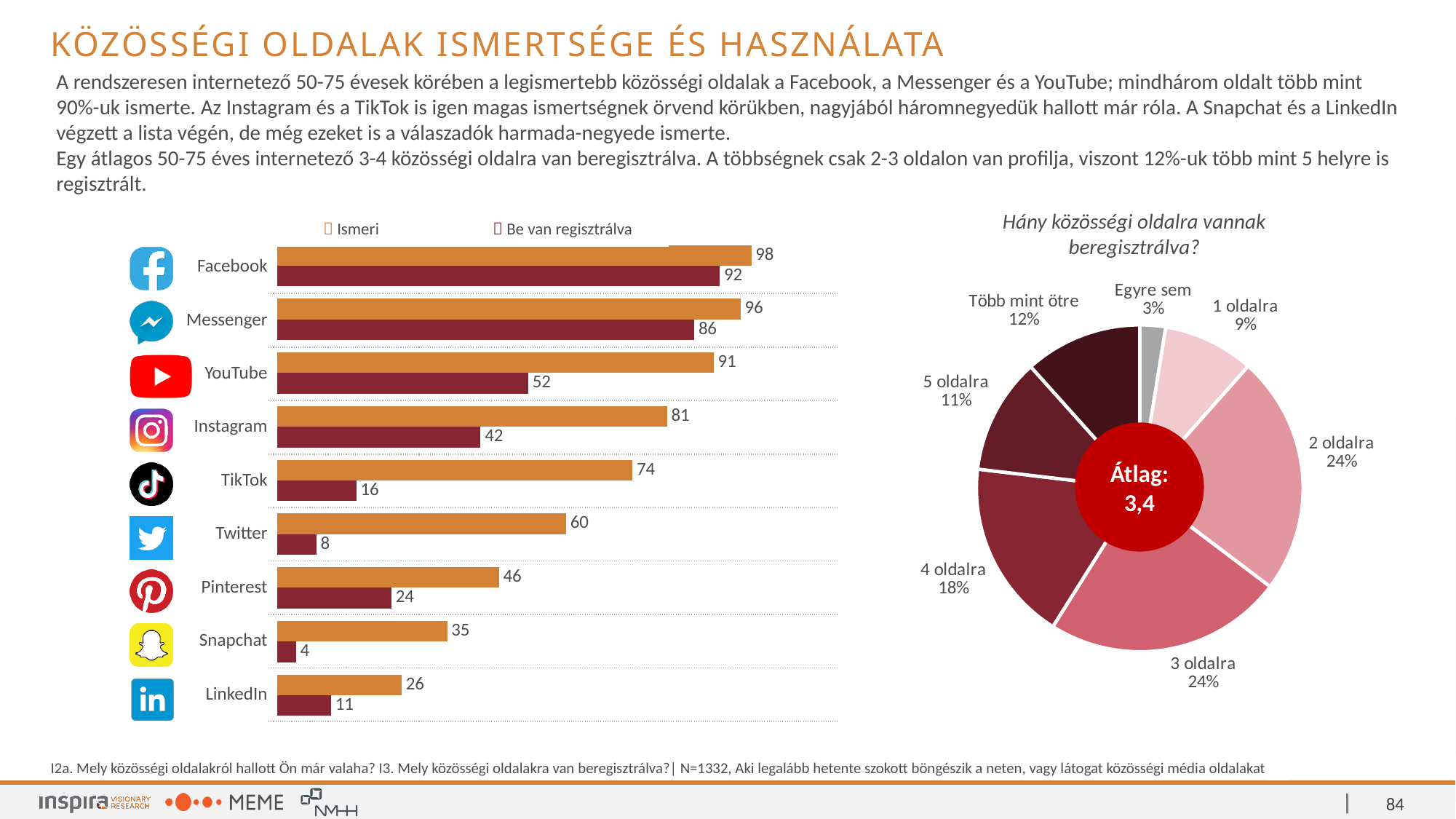
In the bar chart on the left, which is larger: the 'Be van regisztrálva' value for Pinterest or for LinkedIn? Pinterest In the bar chart on the left, what is the difference between the 'Ismeri' and 'Be van regisztrálva' values for TikTok? 58 What kind of chart is the chart on the left of the slide? Bar chart In the bar chart on the left, what is the 'Be van regisztrálva' value for YouTube? 52 What average value is shown in the centre of the pie chart 'Hány közösségi oldalra vannak beregisztrálva?'? 3,4 How many platforms are shown in the bar chart on the left? 9 In the pie chart 'Hány közösségi oldalra vannak beregisztrálva?', what share is '2 oldalra'? 24% In the bar chart on the left, which platform has the highest 'Ismeri' value? Facebook In the bar chart on the left, what is the 'Ismeri' value for Facebook? 98 In the bar chart on the left, which platform has the lowest 'Be van regisztrálva' value? Snapchat How many series does the legend of the bar chart on the left list? 2 In the pie chart 'Hány közösségi oldalra vannak beregisztrálva?', which category has the smallest share? Egyre sem